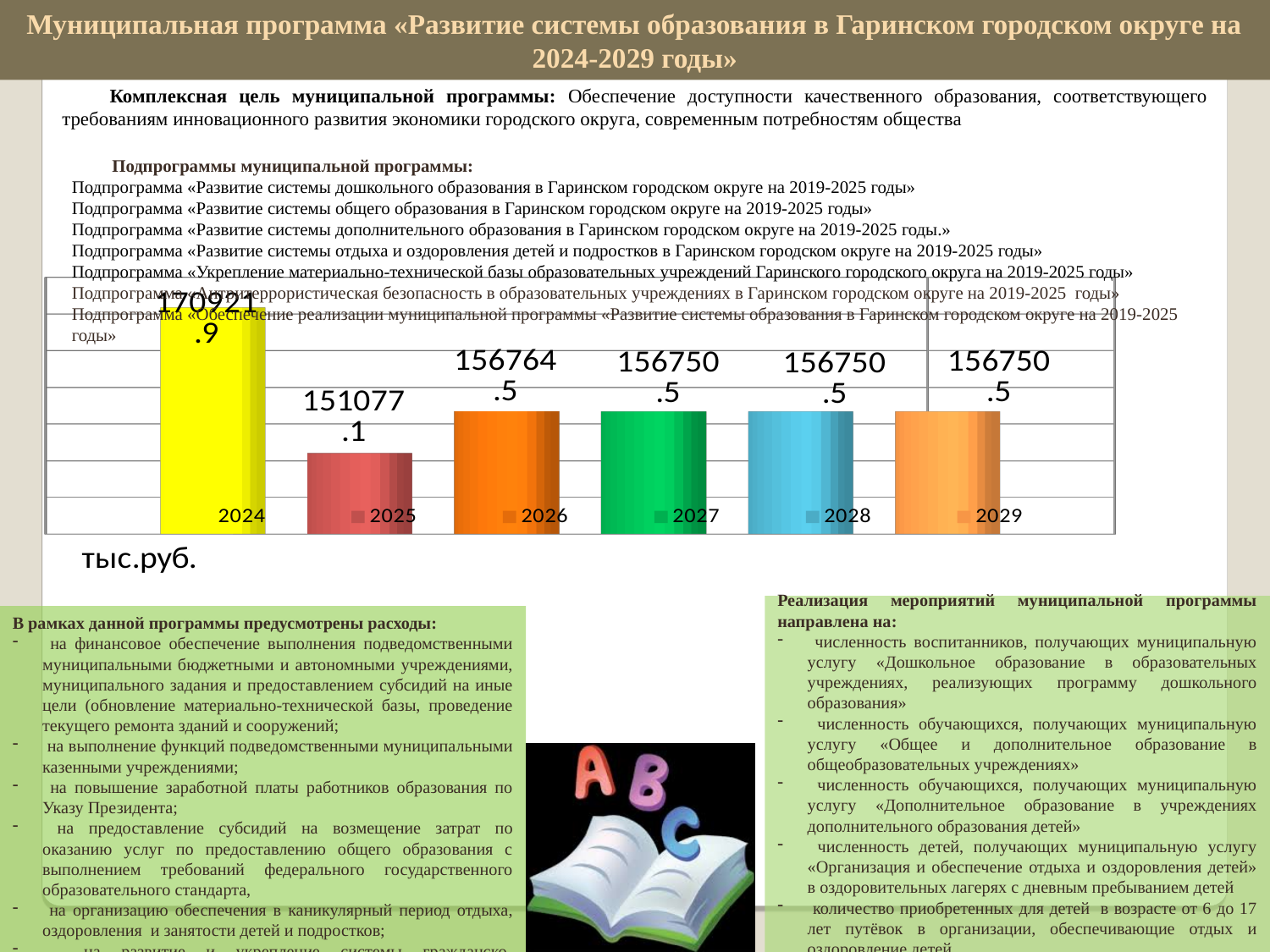
Which year has the lowest value in the bar chart? 2025 What is the value shown for 2026 in the bar chart? 156764.5 What is the value shown for 2029 in the bar chart? 156750.5 What is the value shown for 2025 in the bar chart? 151077.1 What is the difference between the values for 2024 and 2025? 19844.8 Which is larger, the value for 2024 or the value for 2029? 2024 What is the difference between the values for 2026 and 2027? 14 What kind of chart is shown on the slide? bar chart How many years (bars) are shown in the chart? 6 What is the value shown for 2024 in the bar chart? 170921.9 Which year has the highest value in the bar chart? 2024 What unit label is printed below the chart? тыс.руб.